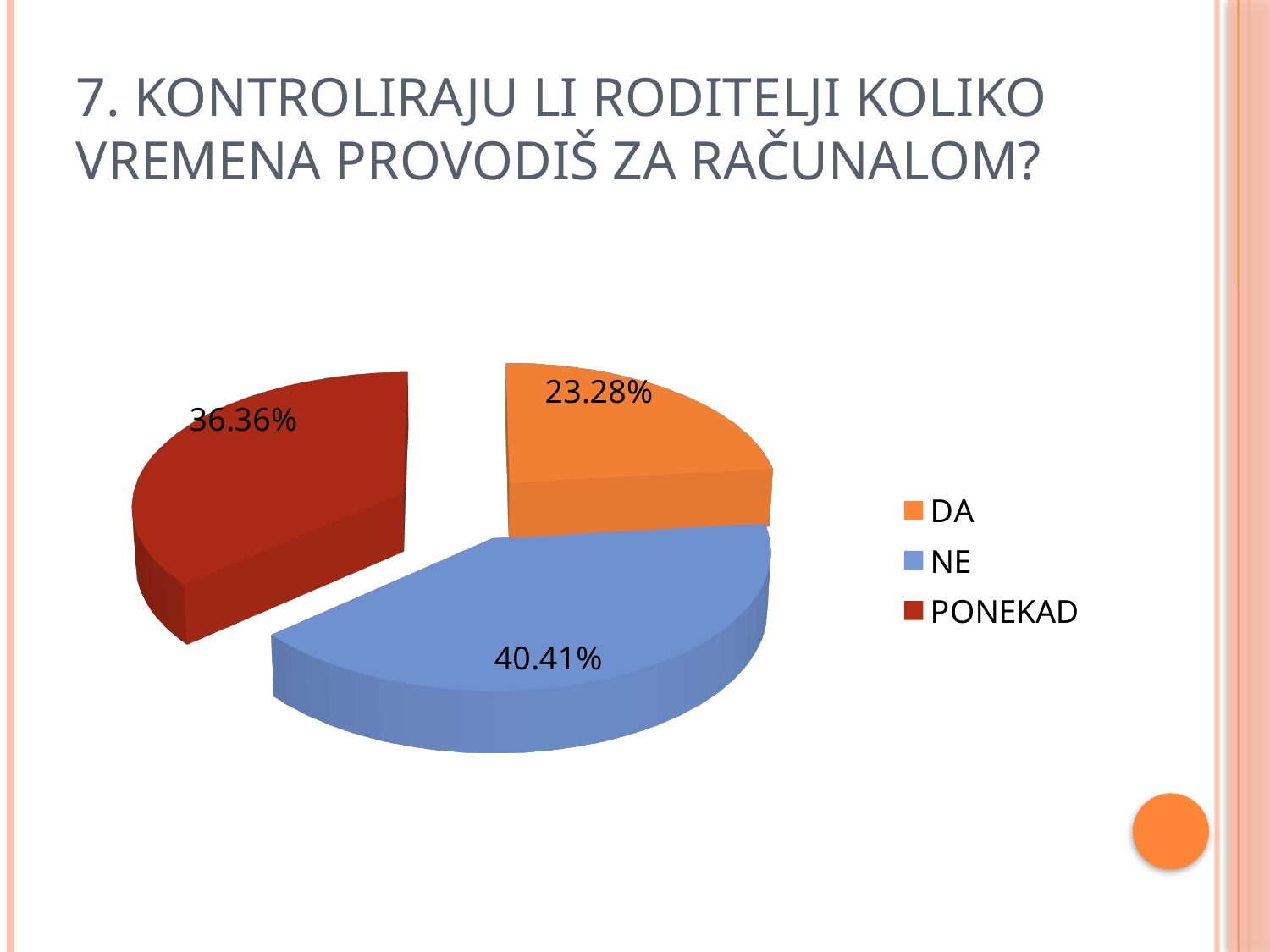
What kind of chart is shown on the slide? pie chart What percentage of the pie is labelled PONEKAD? 36.36% What percentage of the pie is labelled DA? 23.28% What colour is the slice for PONEKAD? red What is the difference in percentage points between the PONEKAD share and the DA share? 13.08 What percentage of the pie is labelled NE? 40.41% Which category has the smallest share of the pie? DA Which is larger, the share for NE or the share for PONEKAD? NE Which is larger, the share for DA or the share for PONEKAD? PONEKAD Which category has the largest share of the pie? NE What is the difference in percentage points between the NE share and the DA share? 17.13 How many categories does the legend list? 3